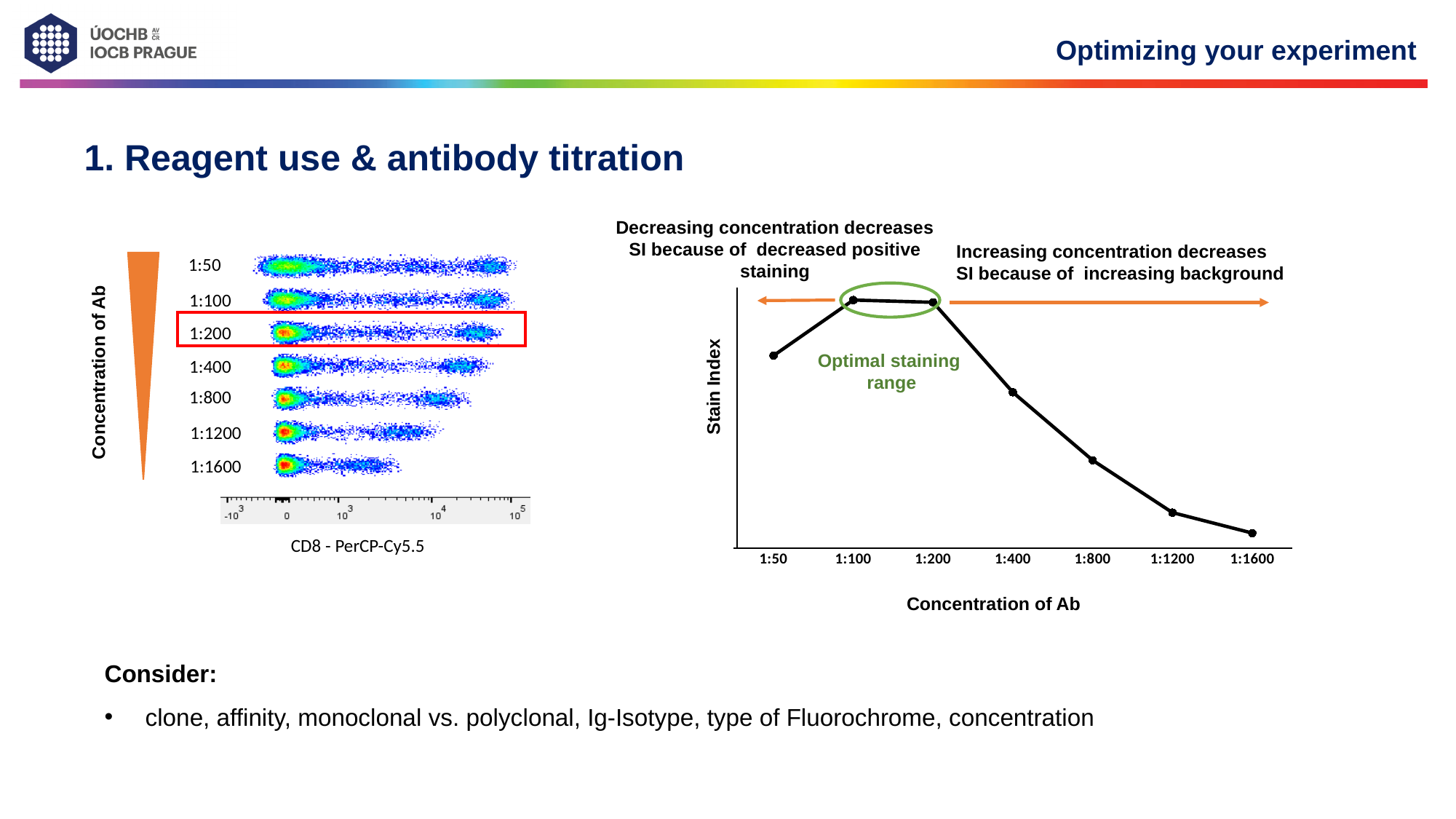
How many antibody concentrations are listed in the dot plot image on the left? 7 On the Stain Index chart, which antibody concentration has the lowest Stain Index? 1:1600 On the Stain Index chart, which has the higher Stain Index, 1:800 or 1:1200? 1:800 What is the x-axis label of the Stain Index chart? Concentration of Ab On the Stain Index chart, which has the higher Stain Index, 1:50 or 1:400? 1:50 How many data points are plotted on the Stain Index line chart? 7 On the Stain Index chart, which has the higher Stain Index, 1:100 or 1:1600? 1:100 In the dot plot image on the left, which antibody concentration is highlighted with a red box? 1:200 What kind of chart is the Stain Index chart on the right of the slide? line chart On the Stain Index chart, does the Stain Index rise or fall from 1:200 to 1:1600? fall On the Stain Index chart, which two concentrations are circled as the optimal staining range? 1:100 and 1:200 On the Stain Index chart, does the Stain Index rise or fall from 1:50 to 1:100? rise